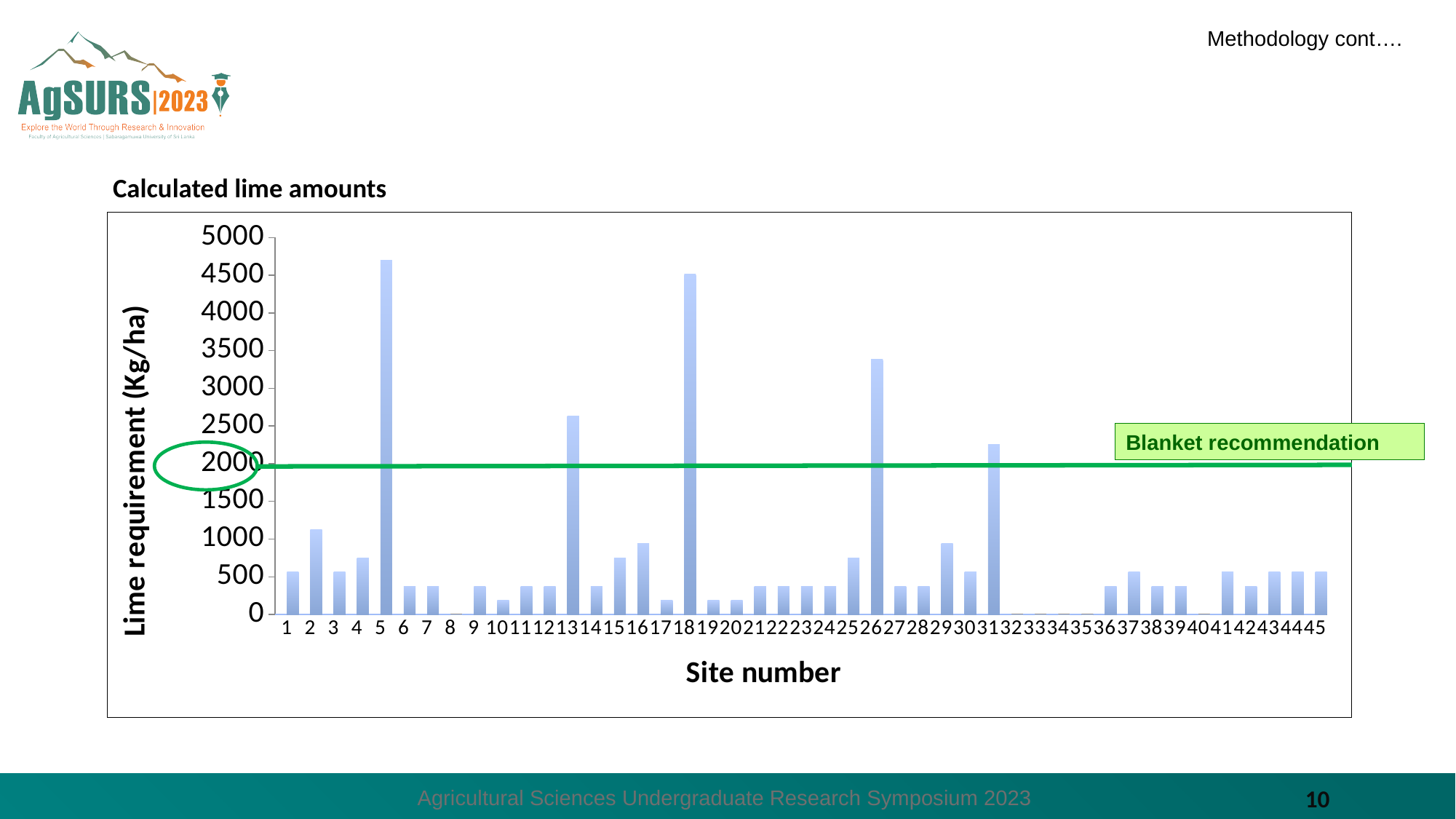
Is the lime requirement for site 31 greater or less than 2000 Kg/ha? greater How many sites have a lime requirement above the blanket recommendation line? 5 What kind of chart is shown on the slide? bar chart Is the lime requirement for site 18 greater or less than 4000 Kg/ha? greater Which site number has the highest lime requirement? 5 Which has the larger lime requirement, site 5 or site 18? site 5 Which has the larger lime requirement, site 2 or site 4? site 2 How many sites are plotted along the x axis of the chart? 45 What is the label on the y axis of the chart? Lime requirement (Kg/ha) Is the lime requirement for site 26 greater or less than 3000 Kg/ha? greater